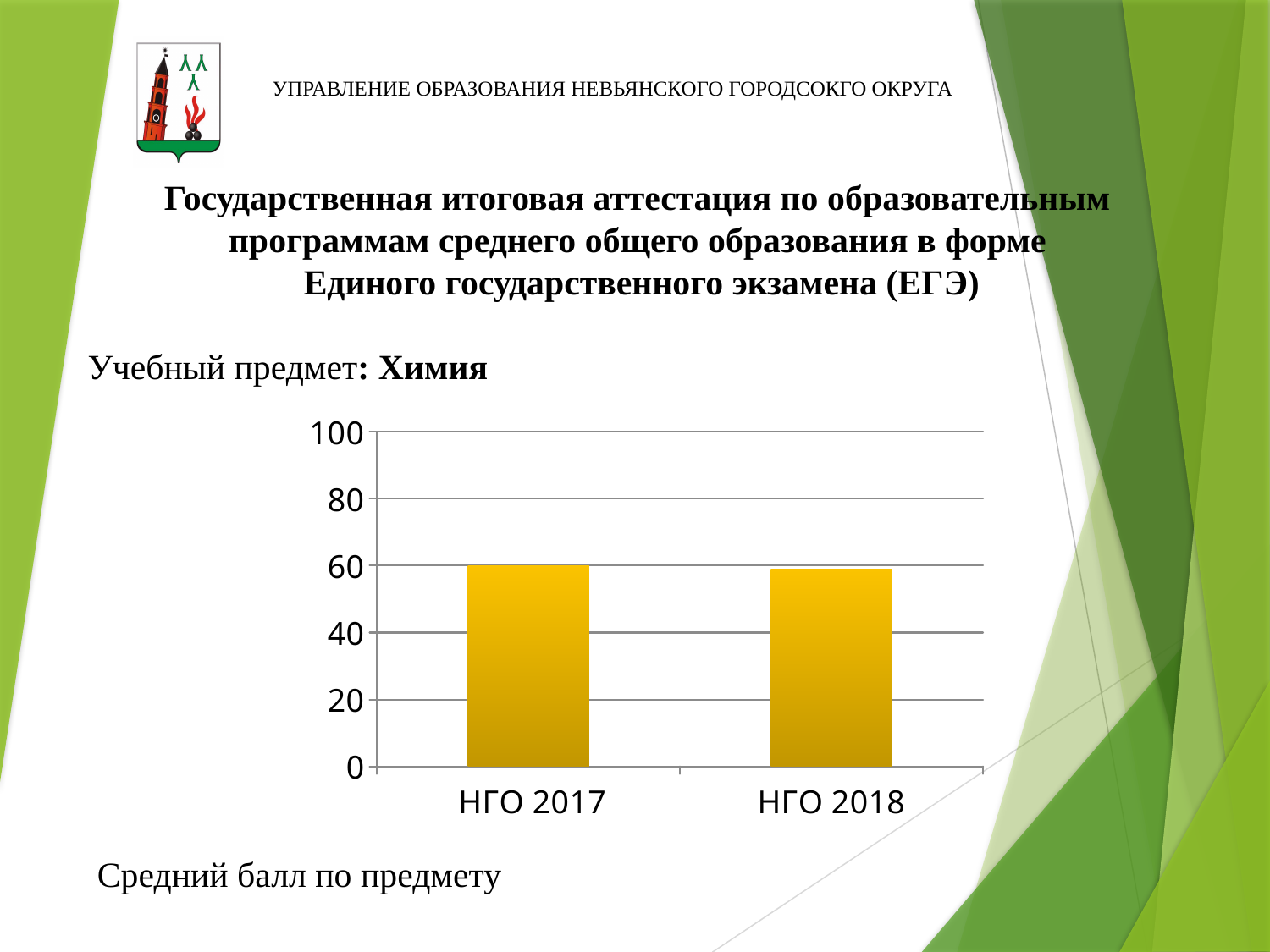
Is the value for НГО 2018 greater or less than 40? greater Is the value for НГО 2017 greater or less than 80? less Is the value for НГО 2017 greater or less than 40? greater How many categories are shown on the x axis of the chart? 2 What kind of chart is shown on the slide? bar chart What is the highest value shown on the vertical axis of the chart? 100 What are the labels of the two categories on the x axis? НГО 2017 and НГО 2018